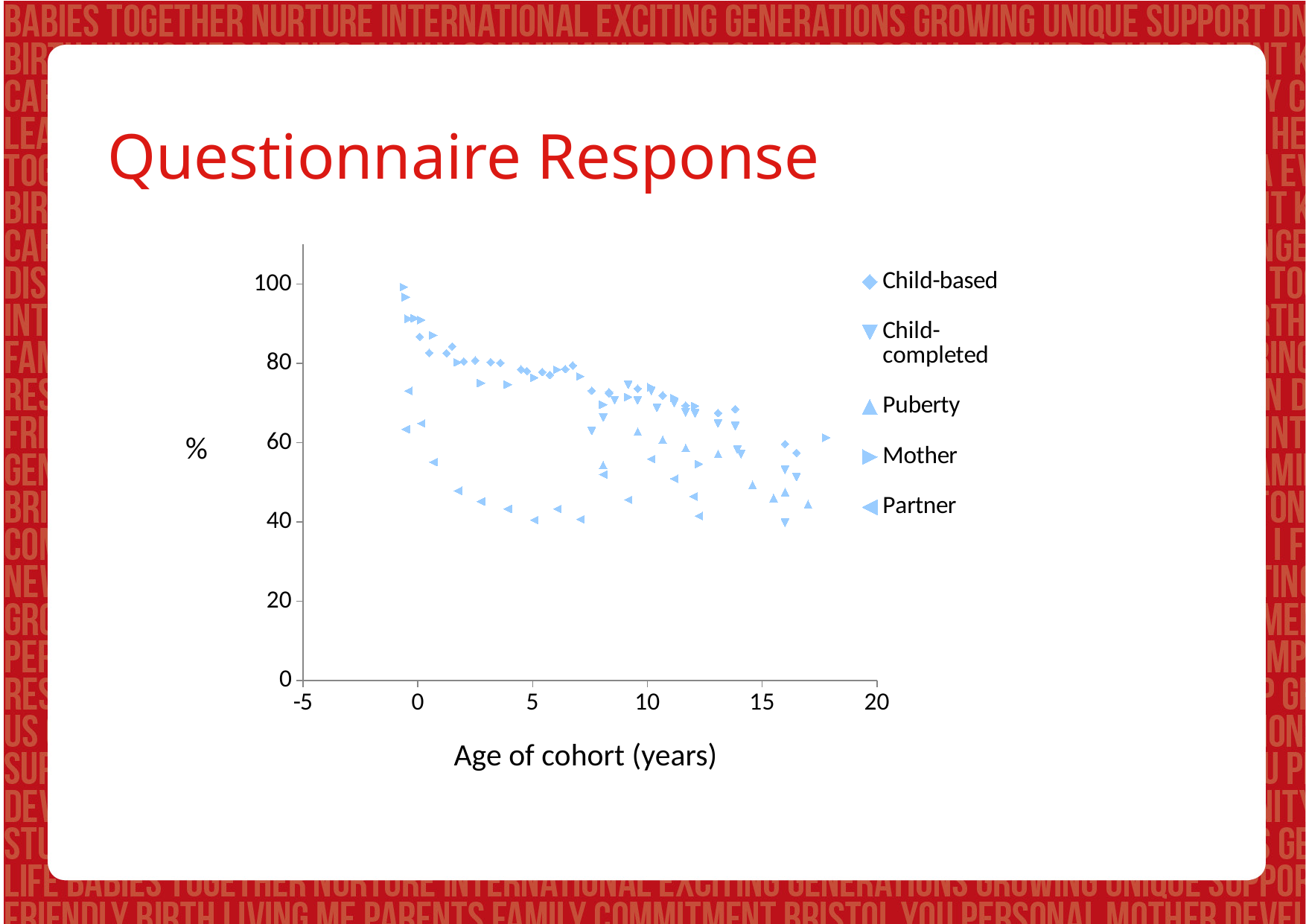
What are the series names listed in the legend? Child-based, Child-completed, Puberty, Mother, Partner At age 5, which series has the higher value, Mother or Partner? Mother Is the Mother value at age 18 greater or less than 40? greater Is the Mother value at age 0 greater or less than 80? greater Is the Partner value at age 5 greater or less than 60? less Which series has the lowest values around age 5? Partner Do the Child-based values rise or fall as the age of cohort increases? Fall What is the title of the x axis? Age of cohort (years) What kind of chart is shown on the slide? Scatter chart How many series does the legend list? 5 What is the highest value shown on the y axis? 100 Which series has the highest value at age 0? Mother